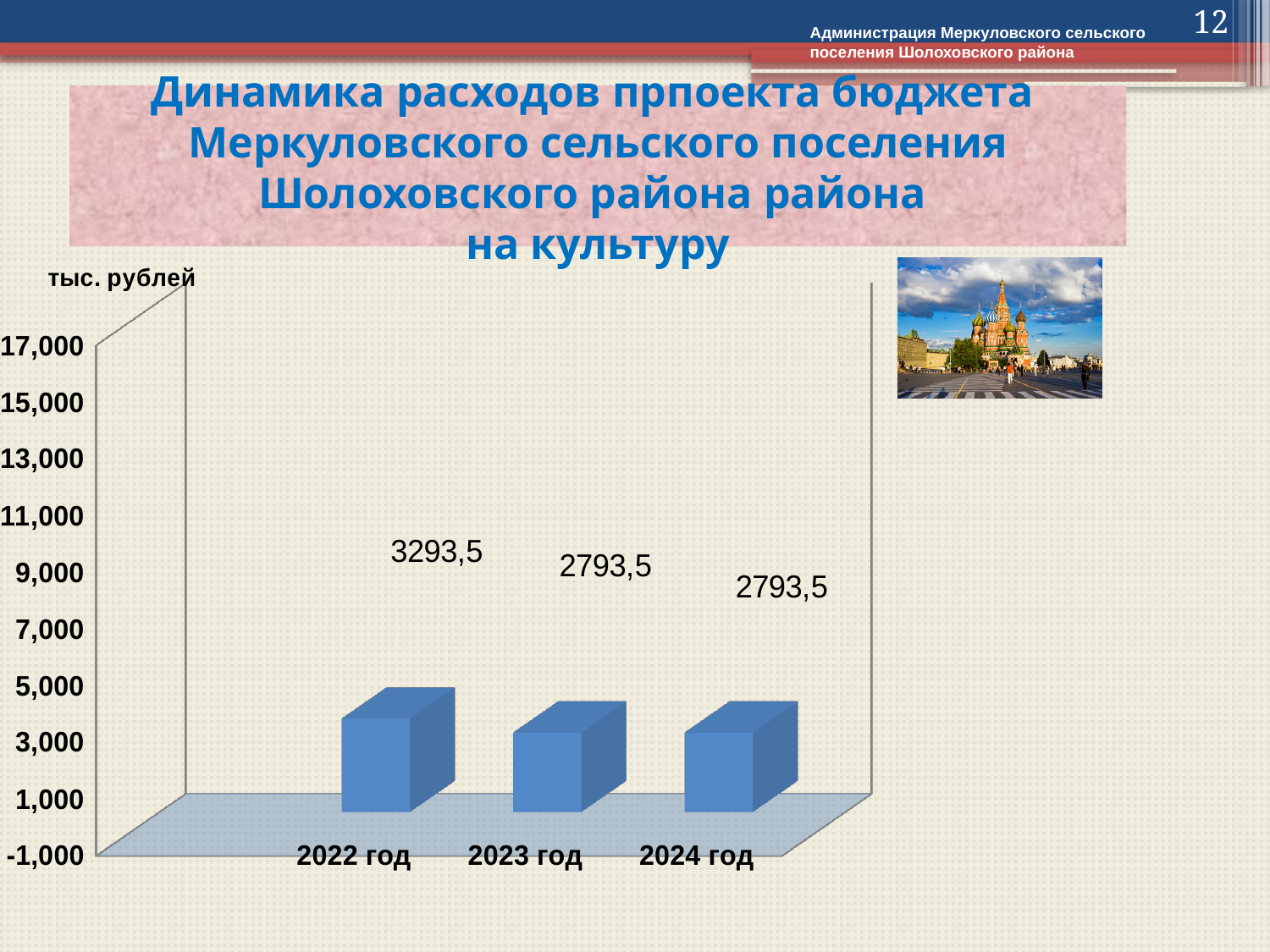
Which is larger, the value for 2022 год or the value for 2024 год? 2022 год What is the value for 2022 год? 3293,5 What is the value for 2024 год? 2793,5 Does the value rise or fall from 2022 год to 2023 год? Falls Is the value for 2023 год greater or less than 5,000? less What is the difference between the values for 2022 год and 2023 год? 500 Are the values for 2023 год and 2024 год the same? Yes What kind of chart is shown on the slide? Bar chart What is the value for 2023 год? 2793,5 How many years are shown on the chart? 3 Is the value for 2022 год greater or less than 3,000? greater Which year has the highest value? 2022 год